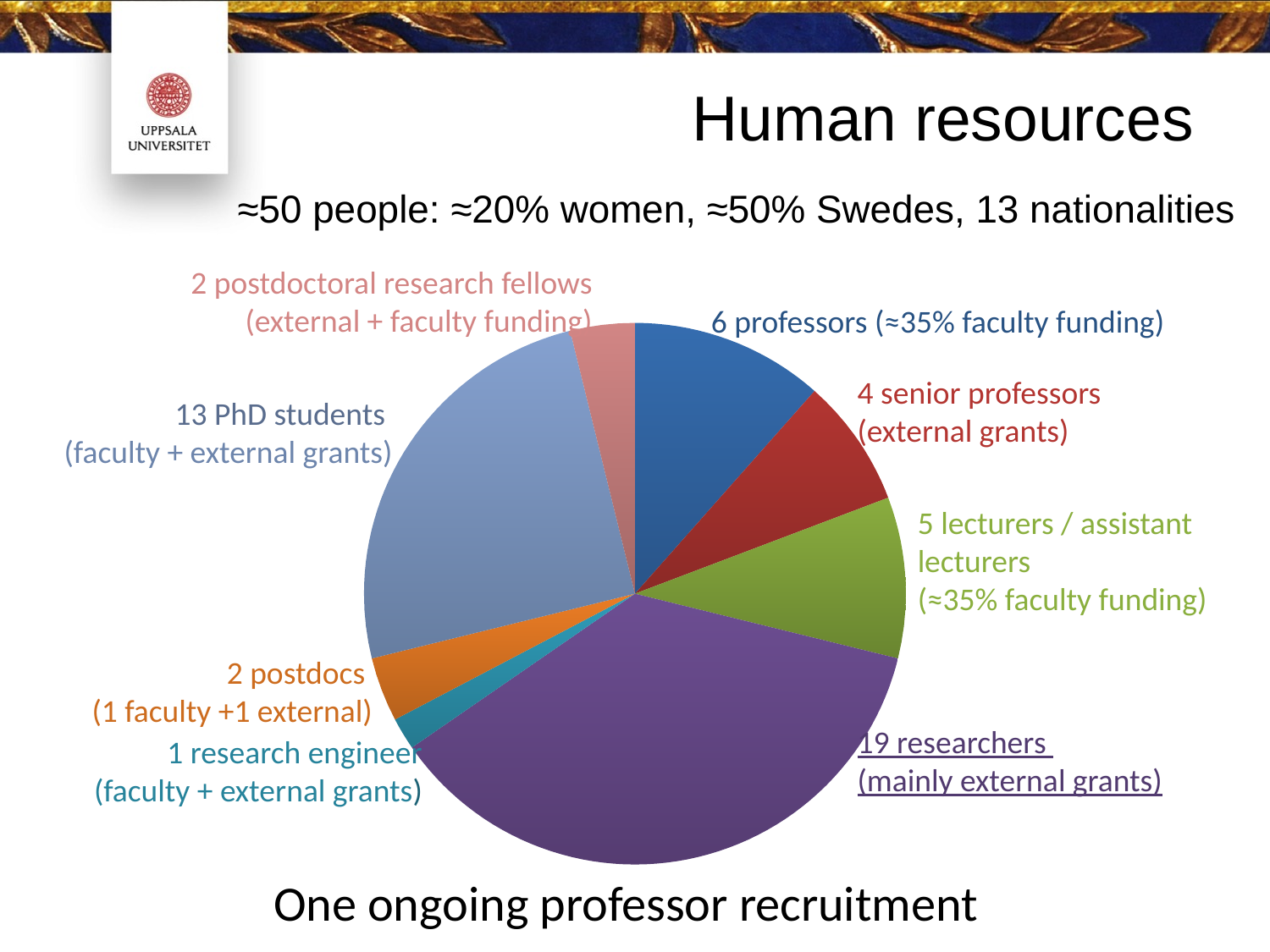
How many lecturers / assistant lecturers are shown in the pie chart? 5 Which category has the largest slice of the pie chart? researchers How many slices does the pie chart have? 8 What kind of chart is shown on the slide? pie chart How many professors are shown in the pie chart? 6 What is the difference between the number of researchers and the number of PhD students? 6 Which category has the smallest slice of the pie chart? research engineer How many PhD students are shown in the pie chart? 13 What colour is the slice for researchers in the pie chart? purple Which is larger: the number of professors or the number of senior professors? professors What is the total number of people across all slices of the pie chart? 52 How many researchers are shown in the pie chart? 19